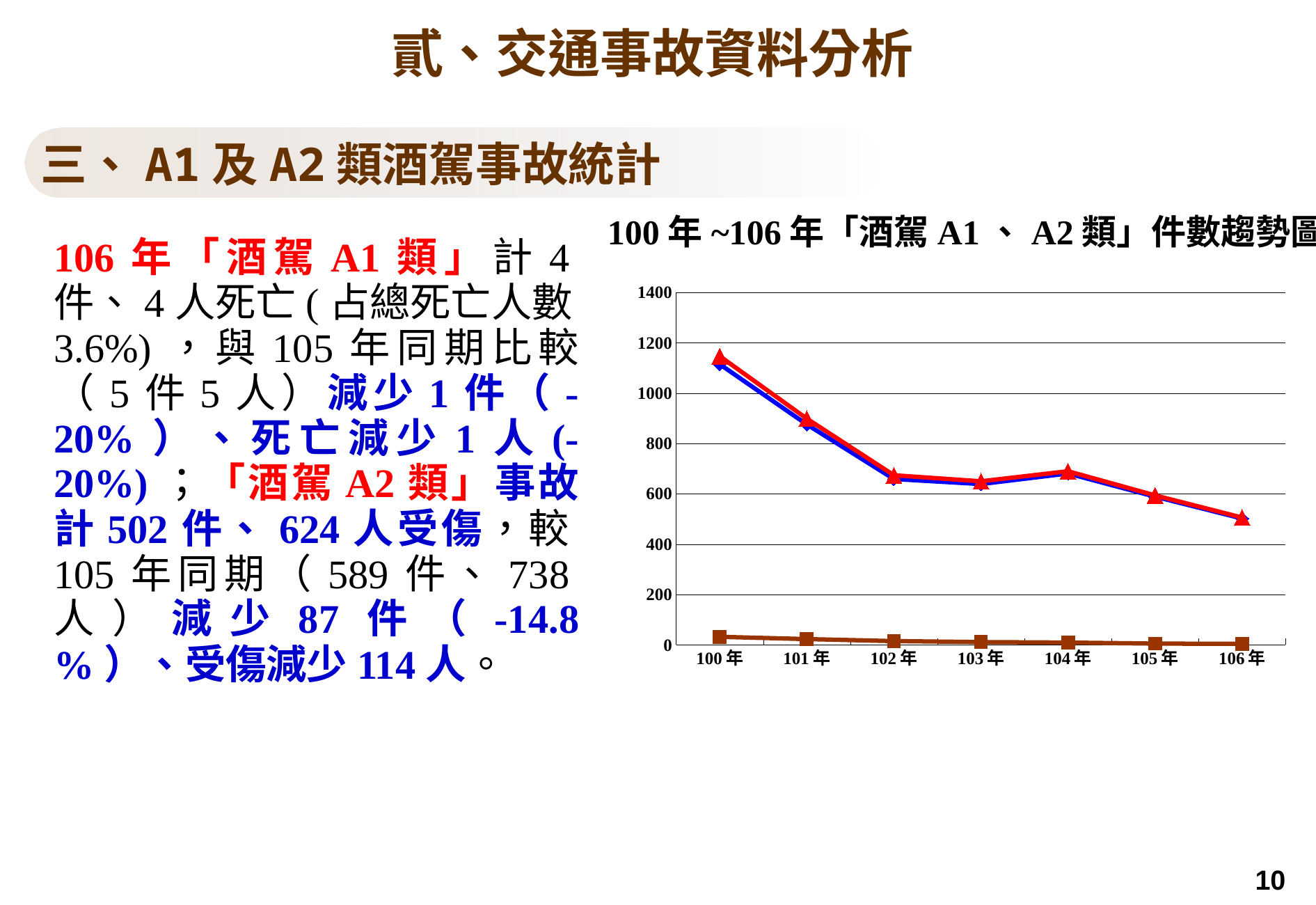
Is the value of the red triangle line for 100年 greater or less than 1000? greater Is the value of the red triangle line for 106年 greater or less than 600? less Is the value of the brown square line for 100年 greater or less than 200? less On the red triangle line, which year has the larger value, 102年 or 105年? 102年 Which year has the lowest value on the red triangle line? 106年 Do the values of the red triangle line generally rise or fall from 100年 to 106年? fall What is the title of the chart? 100年~106年「酒駕A1、A2類」件數趨勢圖 How many years are plotted along the x axis of the chart? 7 What is the highest value shown on the y axis of the chart? 1400 What kind of chart is shown on the slide? line chart Which year has the highest value on the red triangle line? 100年